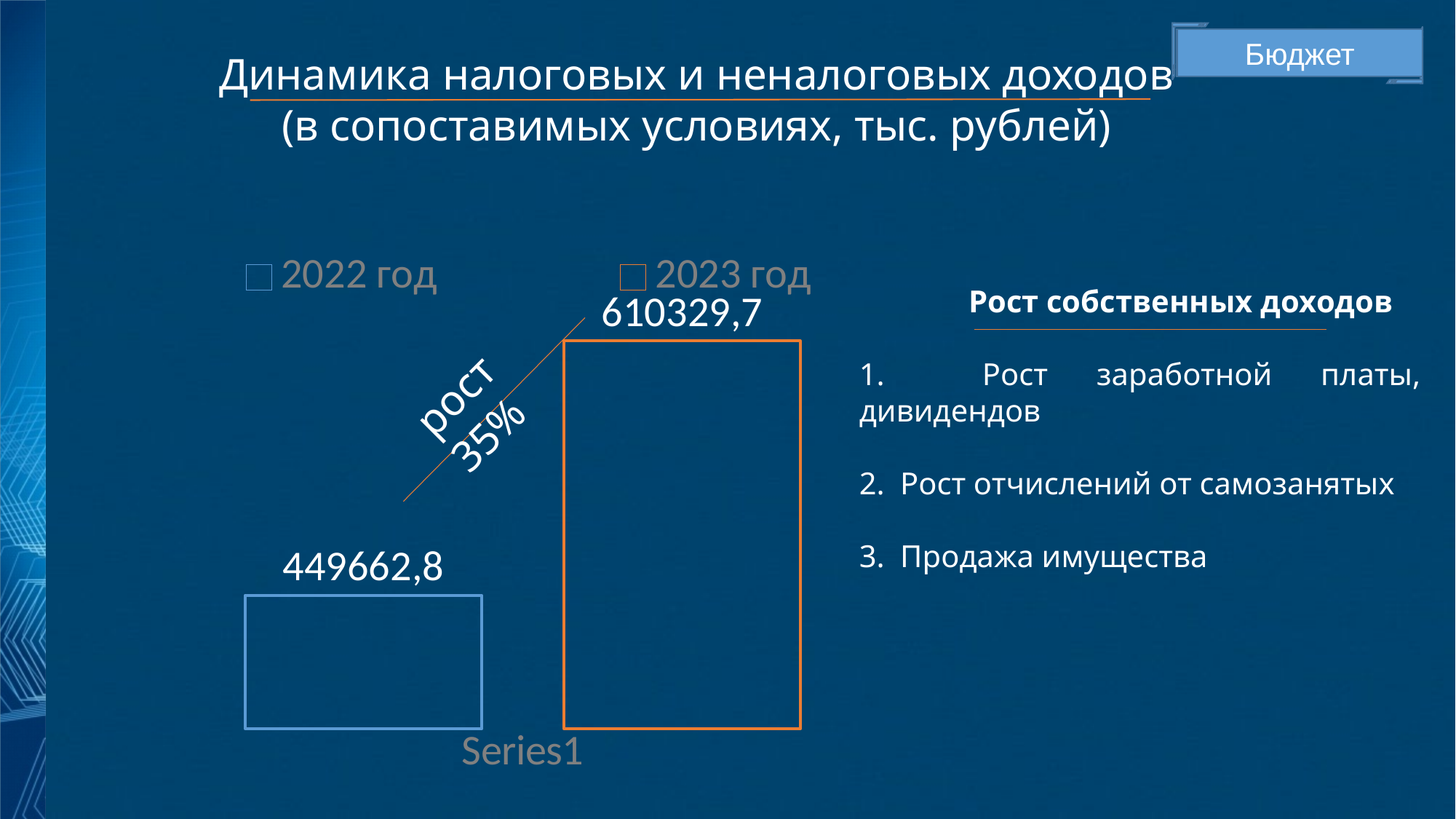
Which series has the higher value, 2022 год or 2023 год? 2023 год What is the value for 2022 год in the chart? 449662,8 What is the difference between the 2023 год value and the 2022 год value? 160666,9 Do the values rise or fall from 2022 год to 2023 год? rise Which series has the lowest value in the chart? 2022 год What growth percentage is annotated between the two bars? 35% What kind of chart is shown on the slide? bar chart How many series does the legend list? 2 Which series has the highest value in the chart? 2023 год What is the value for 2023 год in the chart? 610329,7 What is the category label shown on the x axis of the chart? Series1 How many bars are plotted in the chart? 2